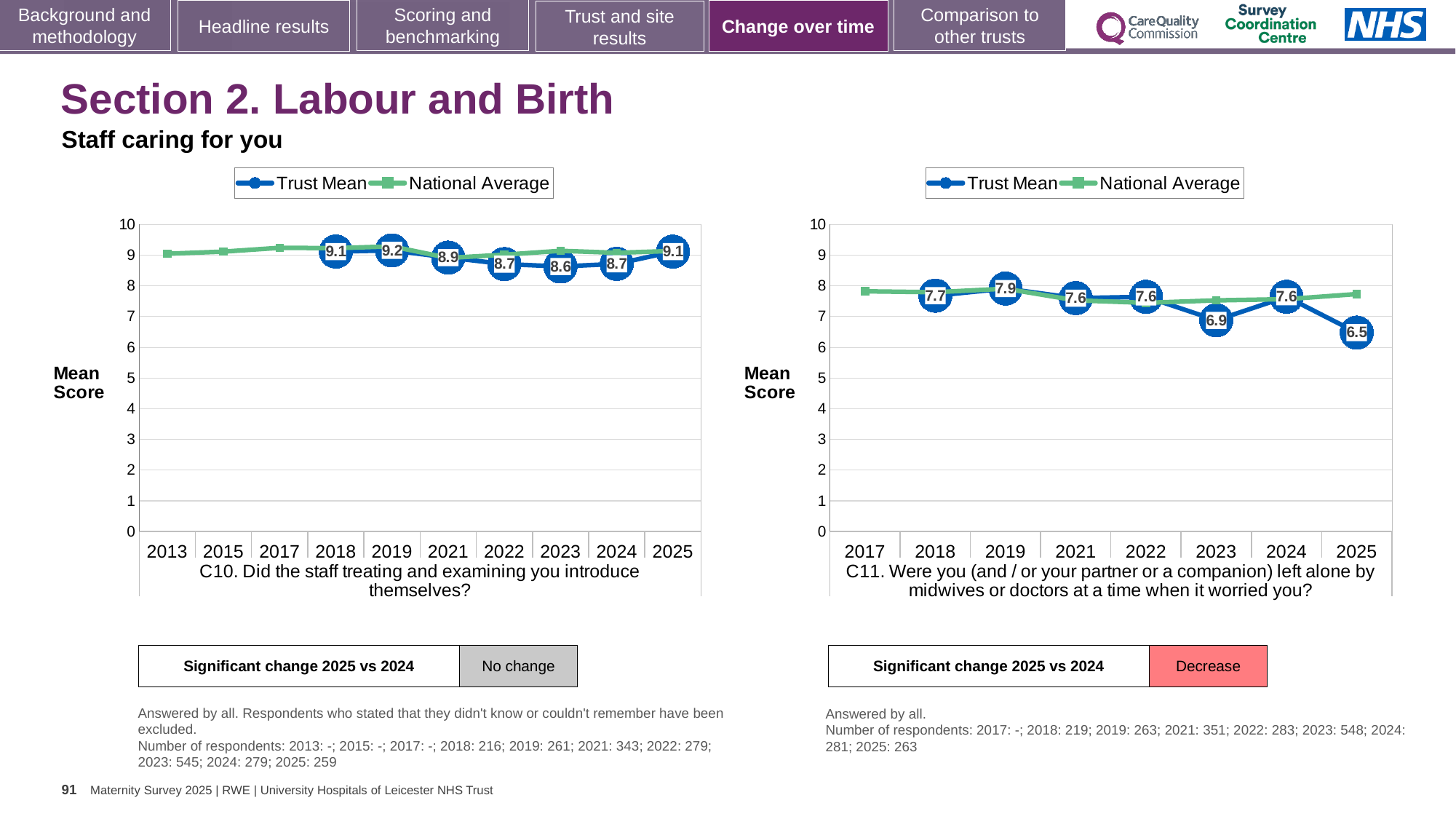
In the right chart (C11), what is the difference between the Trust Mean in 2019 and in 2025? 1.4 In the right chart (C11), is the Trust Mean higher in 2023 or in 2024? 2024 In the left chart (C10), what is the Trust Mean for 2019? 9.2 In the right chart (C11), which year has the highest labelled Trust Mean? 2019 In the left chart (C10), what is the Trust Mean for 2023? 8.6 In the left chart (C10), how many years are shown on the x axis? 10 In the left chart (C10), which year has the lowest labelled Trust Mean? 2023 What kind of chart is the left chart (C10)? Line chart In the right chart (C11), what is the Trust Mean for 2019? 7.9 In the right chart (C11), what is the Trust Mean for 2025? 6.5 How many series does the legend of the right chart (C11) list? 2 In the left chart (C10), what is the difference between the Trust Mean in 2025 and in 2024? 0.4